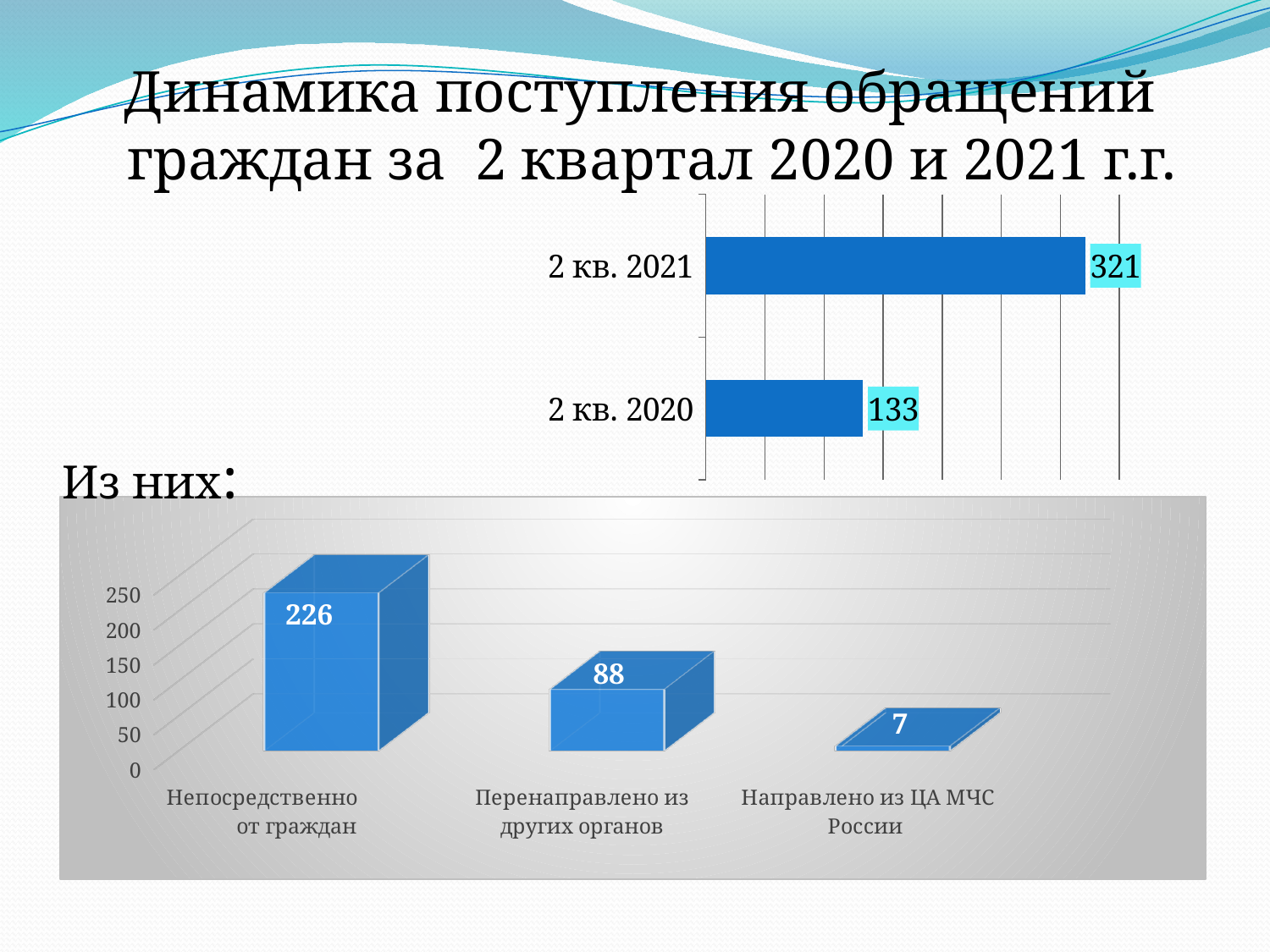
In the bottom chart, what is the value for Непосредственно от граждан? 226 What kind of chart is the top chart? Bar chart How many categories does the bottom chart show? 3 In the bottom chart, what is the value for Перенаправлено из других органов? 88 How many bars does the top chart show? 2 In the top chart, what is the difference between the values for 2 кв. 2021 and 2 кв. 2020? 188 In the top chart, which period has the larger value, 2 кв. 2021 or 2 кв. 2020? 2 кв. 2021 In the bottom chart, what is the value for Направлено из ЦА МЧС России? 7 In the top chart, what is the value for 2 кв. 2020? 133 In the top chart, what is the value for 2 кв. 2021? 321 In the bottom chart, which category has the lowest value? Направлено из ЦА МЧС России In the bottom chart, what is the difference between Непосредственно от граждан and Перенаправлено из других органов? 138